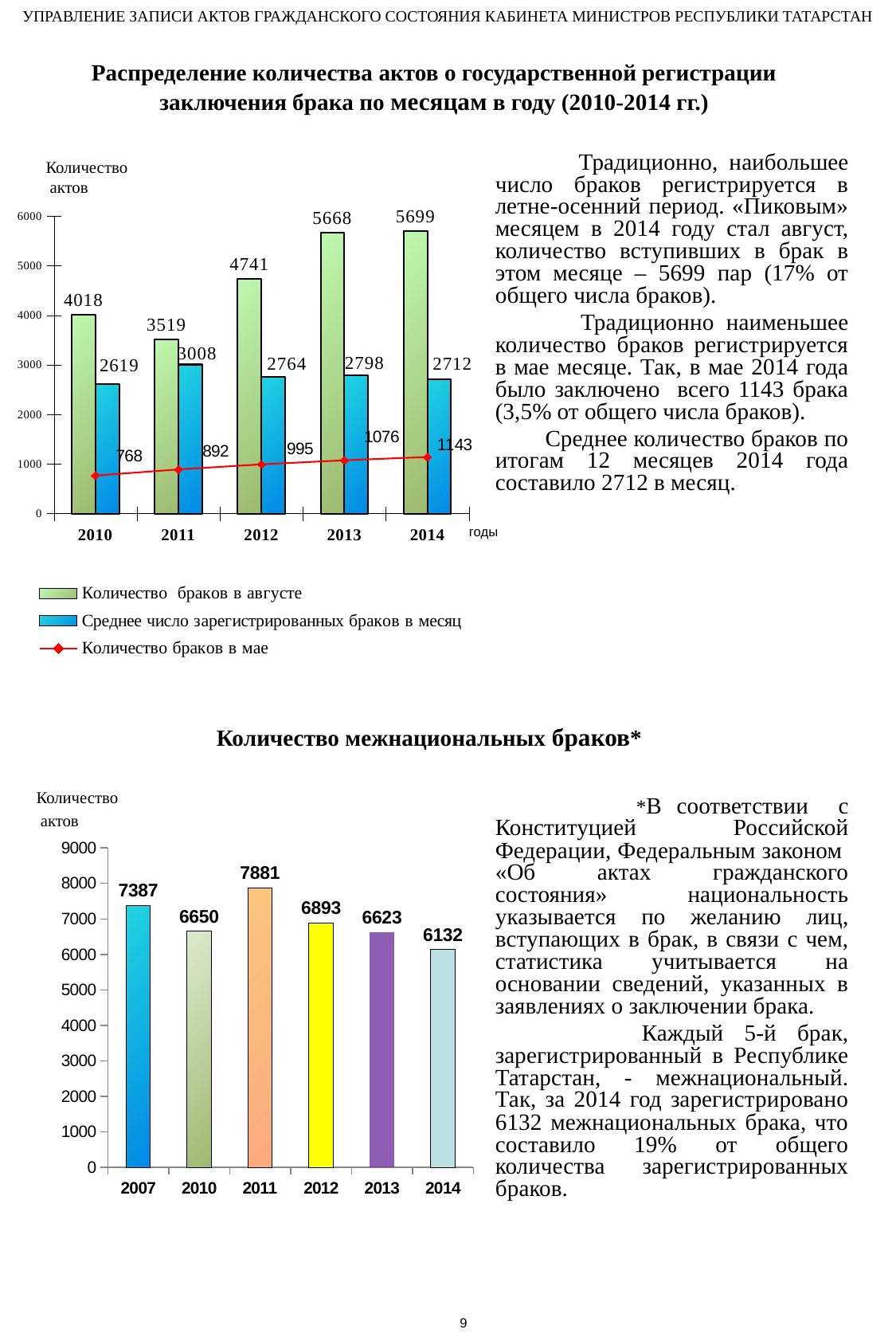
In the bottom chart (interethnic marriages), which year has the lowest value? 2014 In the bottom chart (interethnic marriages), what is the value for 2011? 7881 In the bottom chart (interethnic marriages), how many years are shown? 6 In the top chart (marriages by month, 2010-2014), what is the average monthly number of registered marriages in 2011? 3008 In the bottom chart (interethnic marriages), which is larger, the value for 2012 or the value for 2013? 2012 In the top chart (marriages by month, 2010-2014), what is the number of marriages in August 2014? 5699 What kind of chart is the bottom chart (interethnic marriages)? bar chart In the top chart (marriages by month, 2010-2014), which year has the lowest number of marriages in August? 2011 In the top chart (marriages by month, 2010-2014), what is the difference between the August marriages in 2014 and 2010? 1681 In the top chart (marriages by month, 2010-2014), how many series does the legend list? 3 In the top chart (marriages by month, 2010-2014), does the number of marriages in May rise or fall from 2010 to 2014? rises In the top chart (marriages by month, 2010-2014), what is the number of marriages in May 2012? 995